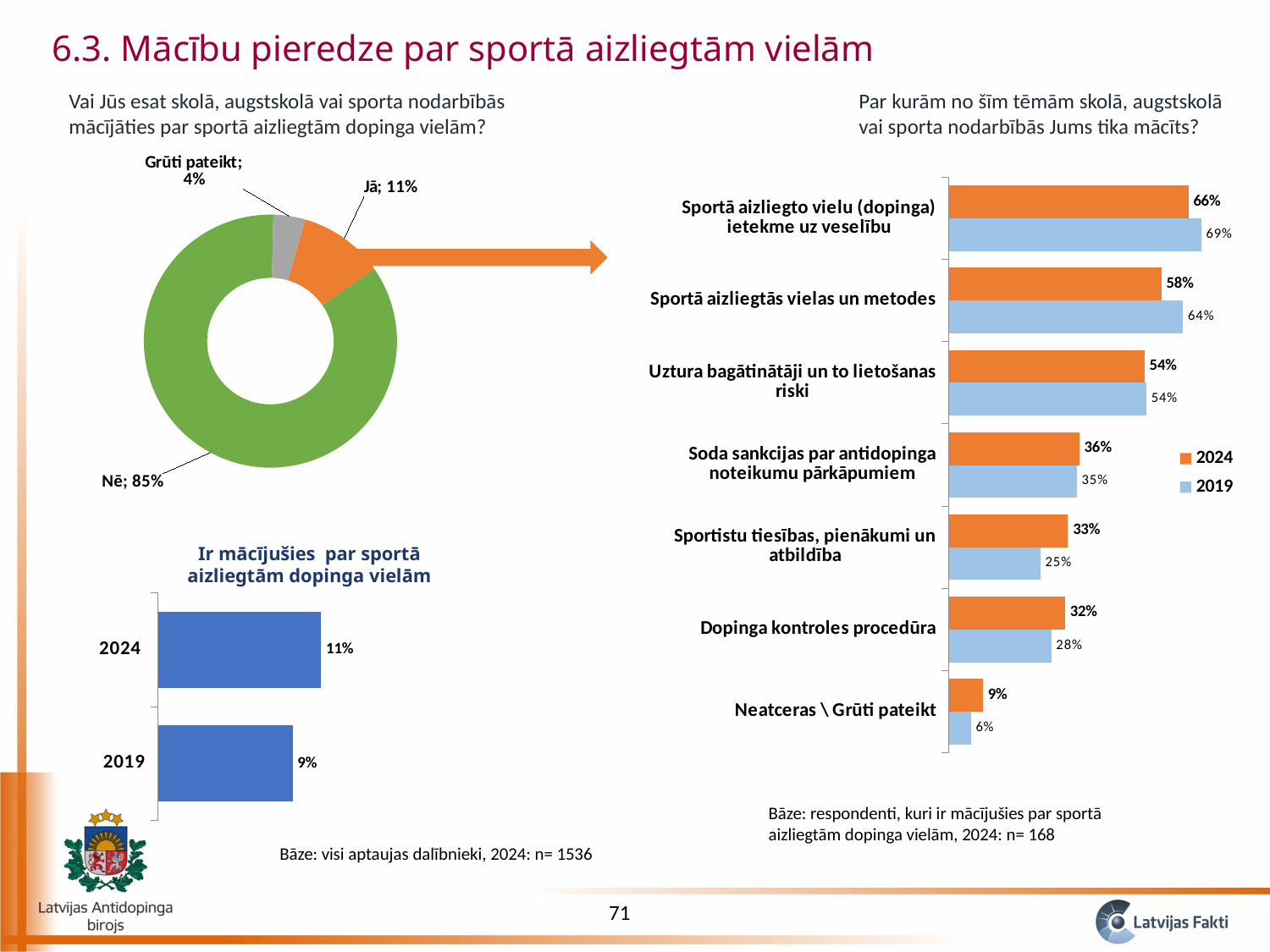
In the donut chart on the top left, how many slices are there? 3 In the donut chart on the top left, what share of respondents answered "Nē"? 85% In the chart titled "Ir mācījušies par sportā aizliegtām dopinga vielām", what is the difference between the 2024 and 2019 values? 2% In the bar chart on the right side of the slide, what is the 2019 value for "Dopinga kontroles procedūra"? 28% In the chart titled "Ir mācījušies par sportā aizliegtām dopinga vielām", what is the value for 2024? 11% In the bar chart on the right side of the slide, how many series does the legend list? 2 In the bar chart on the right side of the slide, is the 2024 value for "Sportistu tiesības, pienākumi un atbildība" larger or smaller than its 2019 value? Larger In the bar chart on the right side of the slide, what is the 2024 value for "Sportā aizliegtās vielas un metodes"? 58% In the bar chart on the right side of the slide, which topic has the highest 2024 value? Sportā aizliegto vielu (dopinga) ietekme uz veselību What kind of chart is the chart titled "Ir mācījušies par sportā aizliegtām dopinga vielām"? Bar chart In the donut chart on the top left, which answer has the smallest share? Grūti pateikt In the donut chart on the top left, what share of respondents answered "Jā"? 11%